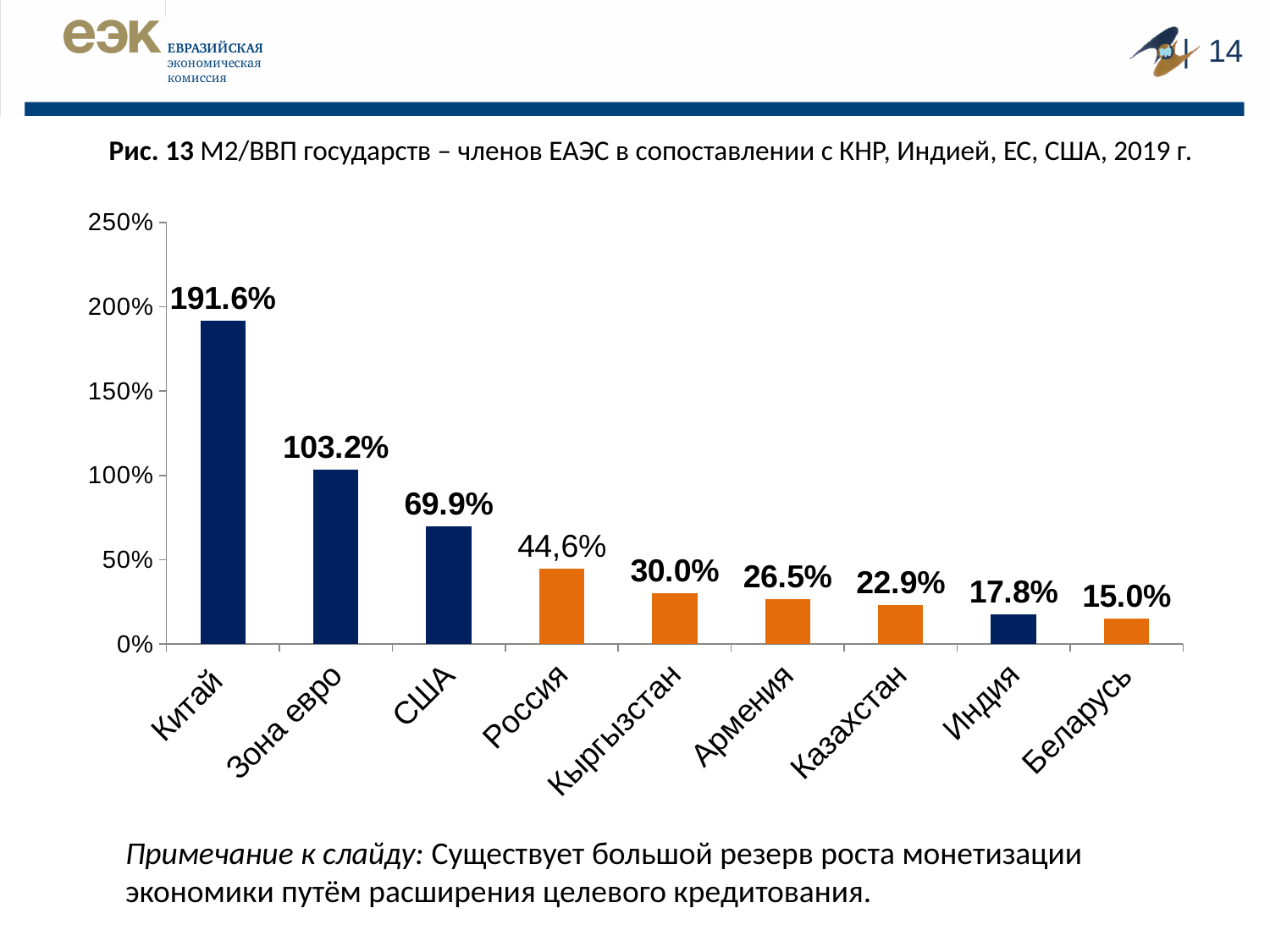
What is the value shown for Казахстан? 22.9% What is the difference between the values for Казахстан and Индия? 5.1% Do the values rise or fall moving from left to right along the x axis? Fall What is the value shown for Беларусь? 15.0% What type of chart is shown on the slide? Bar chart Which category has the highest value in the chart? Китай How many categories (countries/regions) are shown in the chart? 9 What value is labelled on the bar for Россия? 44,6% Which has a larger value, США or Зона евро? Зона евро What is the difference between the values for Китай and Зона евро? 88.4% Which category has the lowest value in the chart? Беларусь What is the M2/GDP value shown for Китай? 191.6%